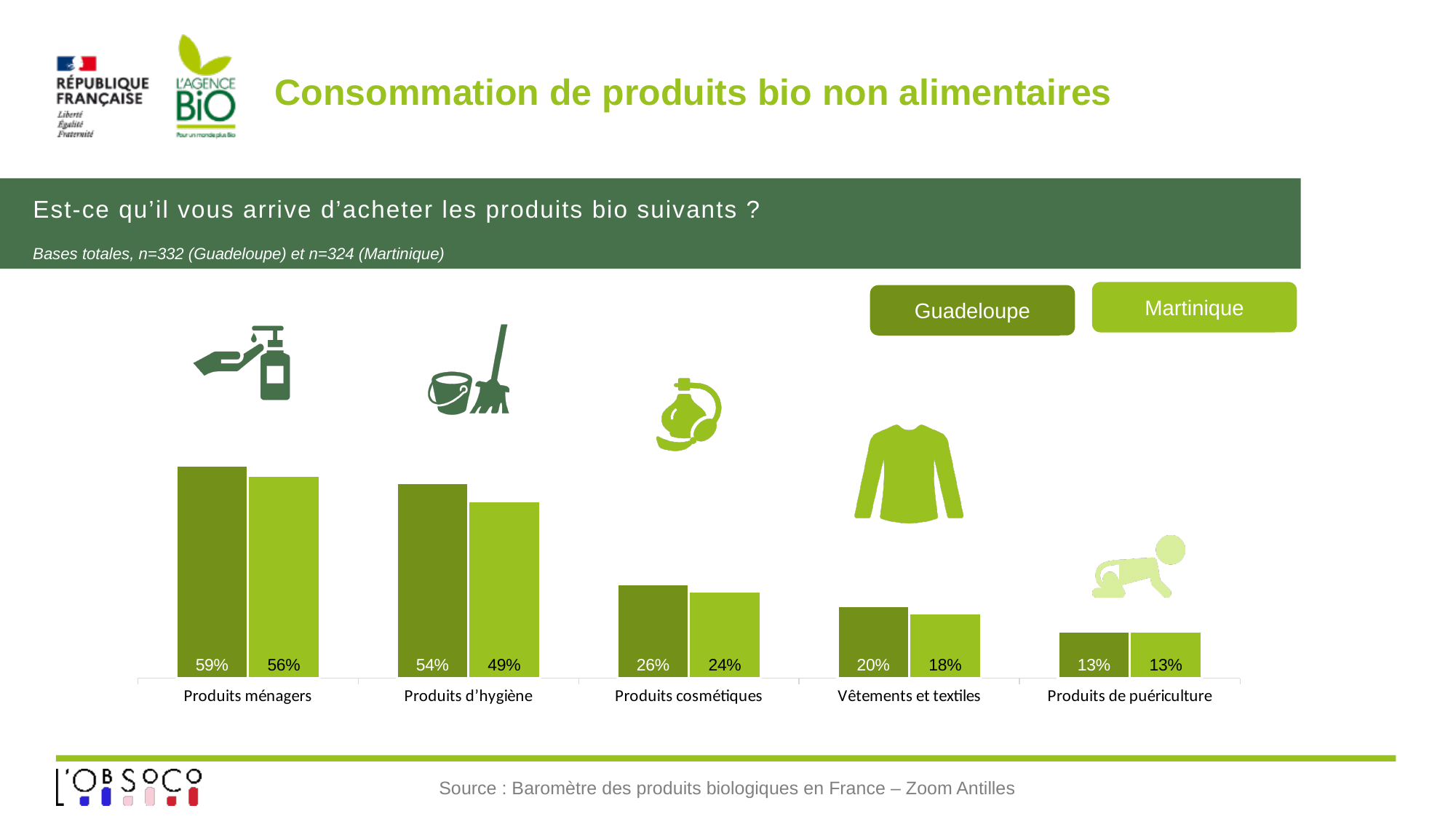
What is the value for Guadeloupe for Produits ménagers? 59% What is the value for Martinique for Produits d'hygiène? 49% Which is larger for Produits cosmétiques, Guadeloupe or Martinique? Guadeloupe What is the value for Guadeloupe for Vêtements et textiles? 20% Which category has the highest value for Guadeloupe? Produits ménagers Do the Martinique values rise or fall from left to right across the categories? Fall How many series does the legend list? 2 Which category has the lowest value for Martinique? Produits de puériculture What kind of chart is shown on the slide? Bar chart What is the value for Martinique for Produits cosmétiques? 24% How many product categories are shown on the chart? 5 What is the difference between Guadeloupe and Martinique for Produits d'hygiène? 5 percentage points